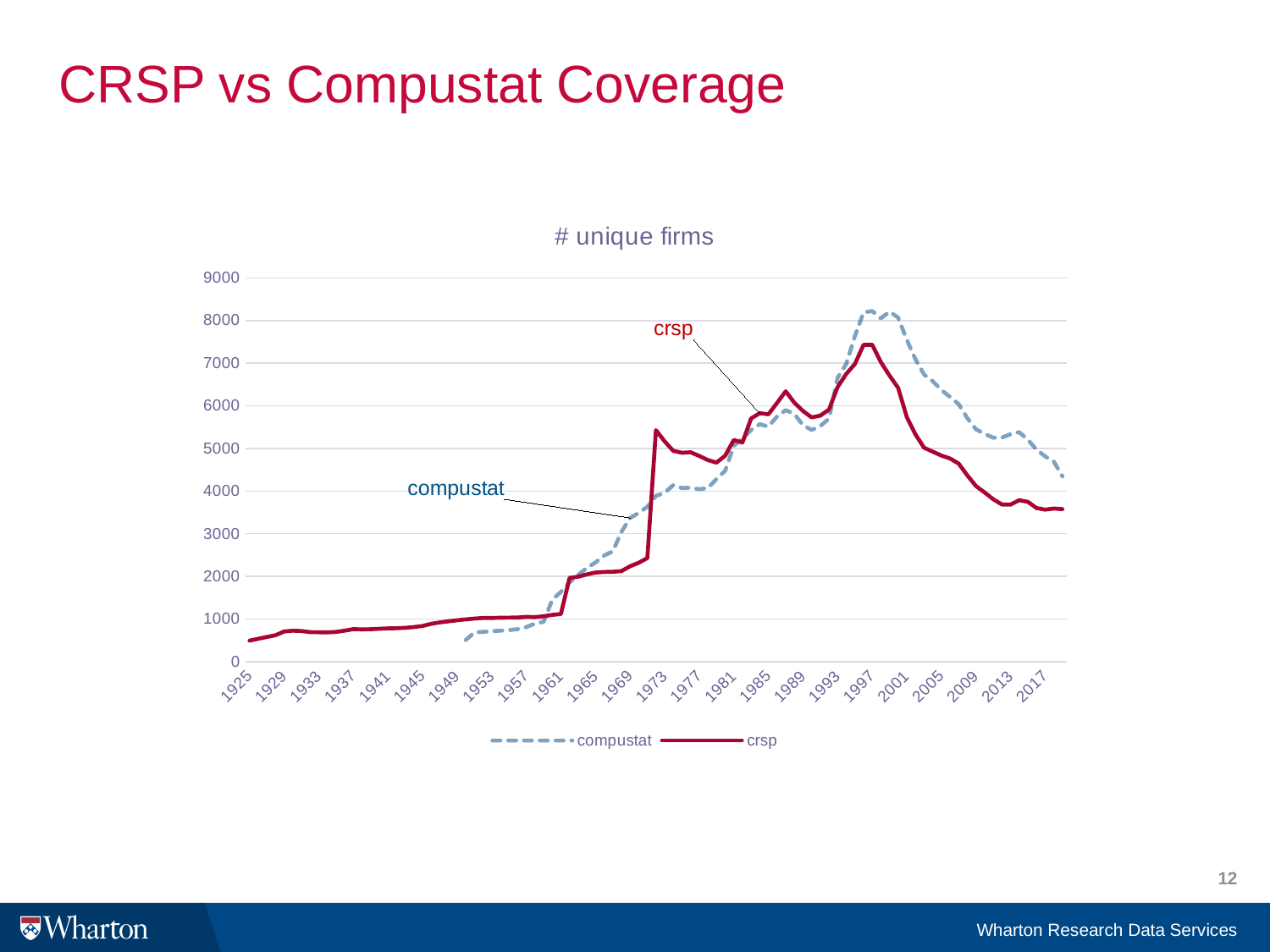
In 1973, which series has the larger value, compustat or crsp? crsp Is the value for crsp in 2017 greater or less than 4000? less Is the value for compustat in 1997 greater or less than 8000? greater In 2009, which series has the larger value, compustat or crsp? compustat Does the crsp series rise or fall between 1997 and 2017? fall Is the value for crsp in 1997 greater or less than 7000? greater What is the title of the chart? # unique firms What kind of chart is shown on the slide? line chart Which series is drawn with a dashed line? compustat How many series does the legend list? 2